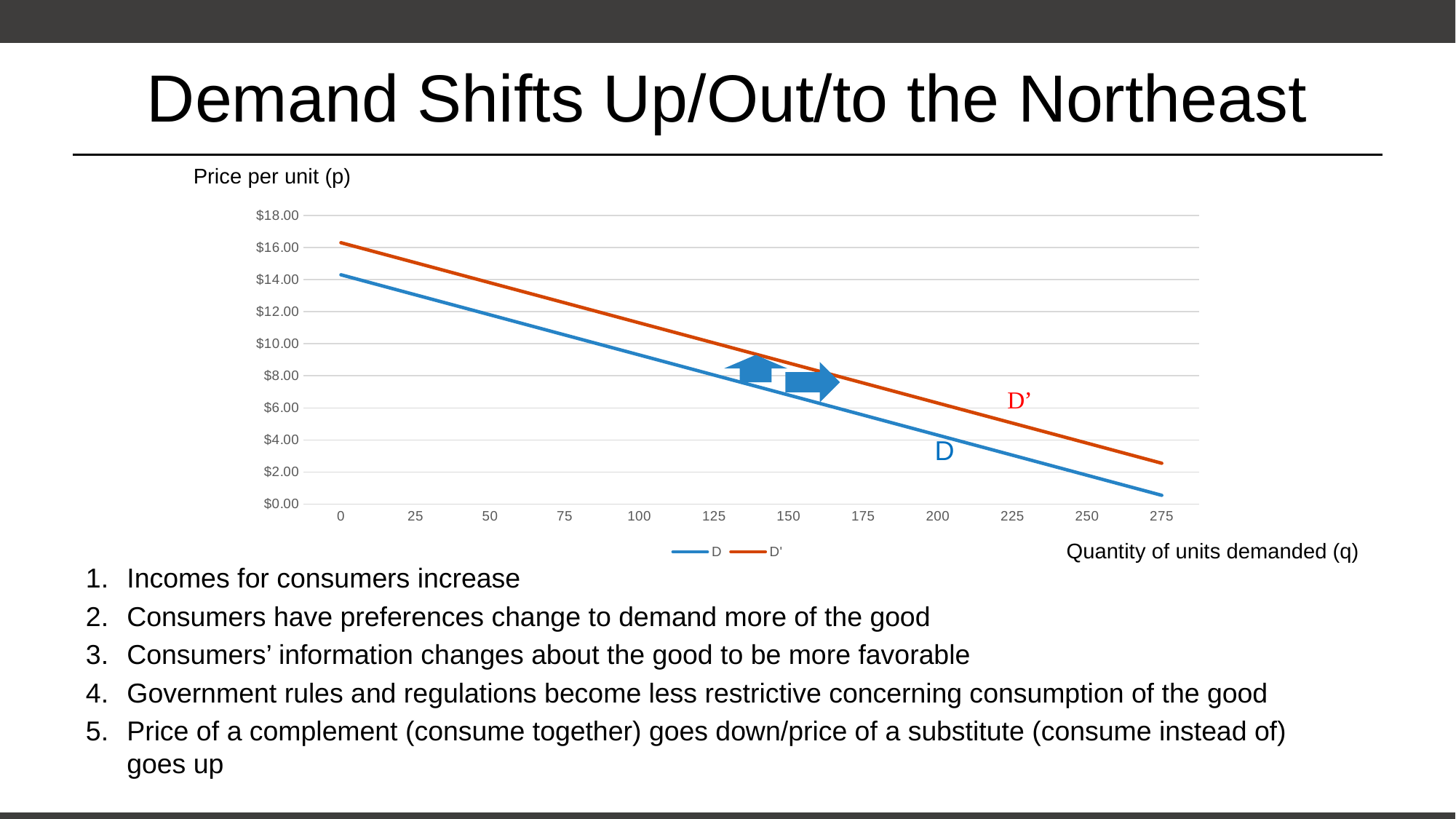
What kind of chart is shown on the slide? line chart What are the two series named in the legend? D and D' Do the values of the D line rise or fall as quantity increases along the x axis? fall How many tick labels are shown on the x axis? 12 How many series does the legend list? 2 Do the values of the D' line rise or fall as quantity increases along the x axis? fall Is the value of the D line at quantity 0 greater or less than $12.00? greater Is the value of the D line at quantity 275 greater or less than $2.00? less Which line lies higher on the chart, D or D'? D' Is the value of the D' line at quantity 0 greater or less than $14.00? greater What is the label of the vertical axis? Price per unit (p)